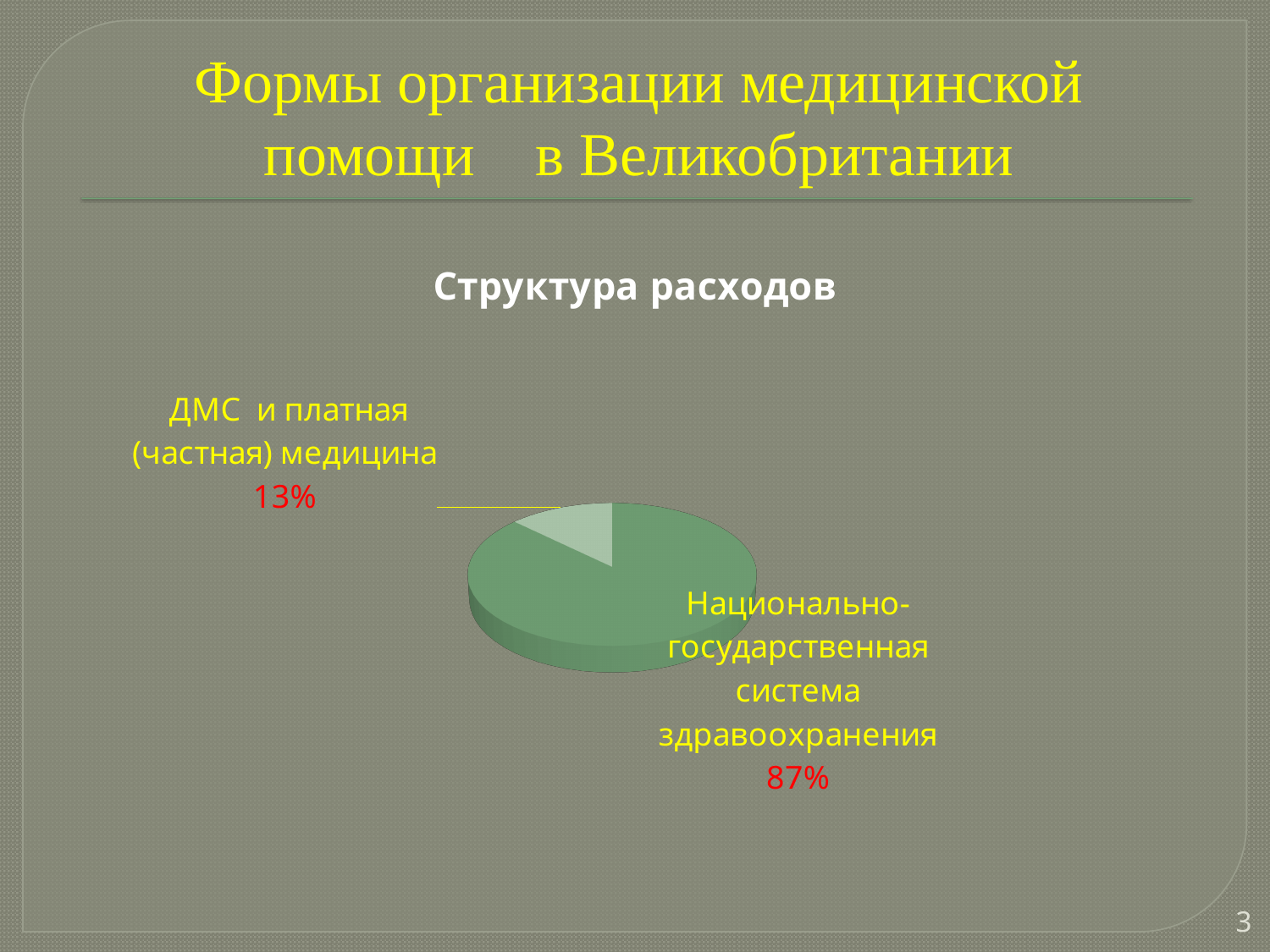
Which is larger: the share for 'ДМС и платная (частная) медицина' or the share for 'Национально-государственная система здравоохранения'? Национально-государственная система здравоохранения Which category has the largest slice of the pie? Национально-государственная система здравоохранения What is the total of the two percentages shown on the pie chart? 100% What share of the pie does the 'Национально-государственная система здравоохранения' slice represent? 87% Which category has the smallest slice of the pie? ДМС и платная (частная) медицина What is the difference in percentage points between the 'Национально-государственная система здравоохранения' slice and the 'ДМС и платная (частная) медицина' slice? 74 What kind of chart is shown on the slide? Pie chart What share of the pie does the 'ДМС и платная (частная) медицина' slice represent? 13% What is the title of the chart? Структура расходов How many slices does the pie chart have? 2